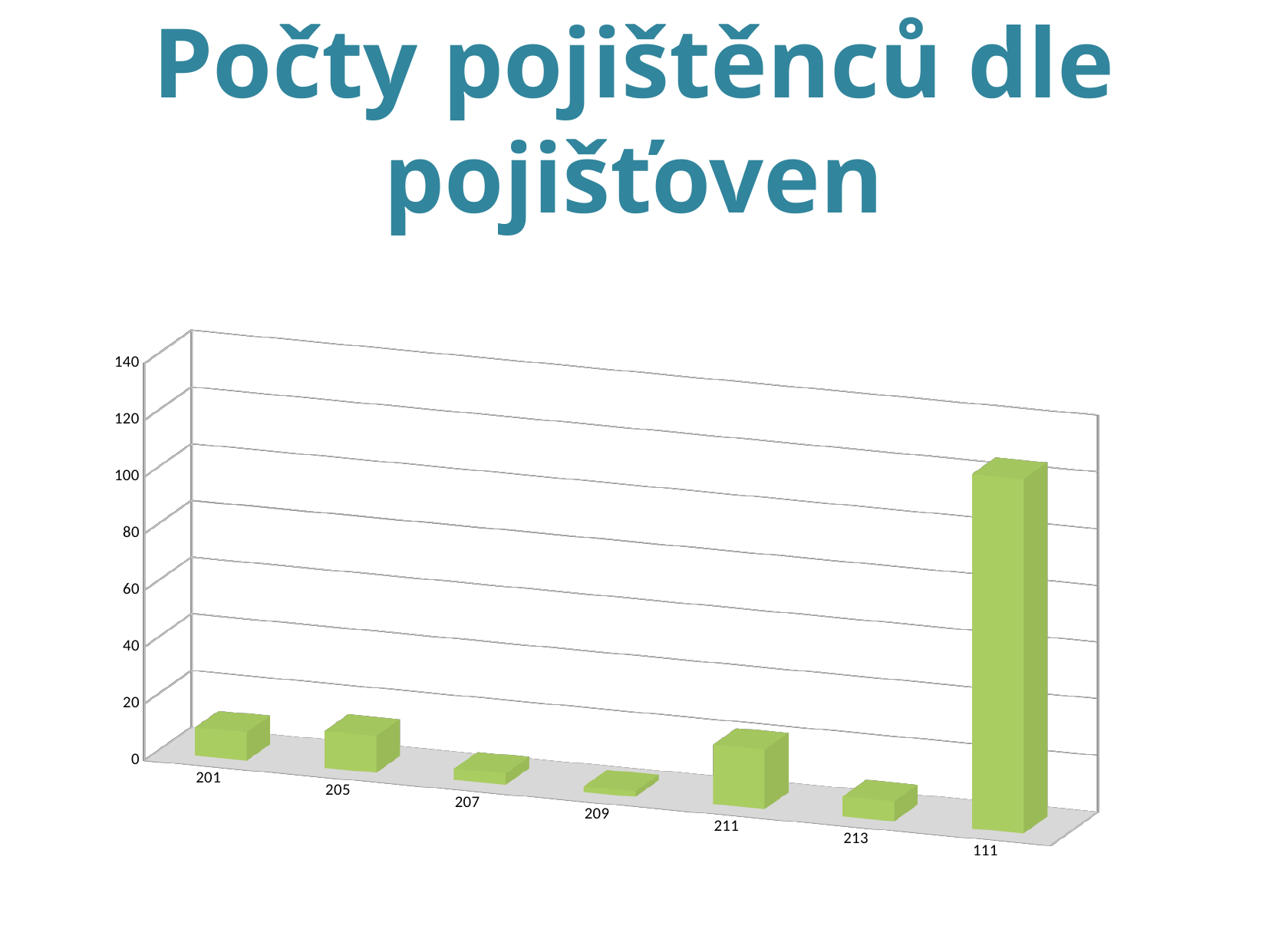
Which has the larger value, 111 or 201? 111 What colour are the bars in the chart? green What is the title of the slide? Počty pojištěnců dle pojišťoven Which category has the highest value in the chart? 111 What type of chart is shown on the slide? bar chart Is the value for 111 greater or less than 80? greater Which has the larger value, 211 or 209? 211 How many categories are shown on the x axis of the chart? 7 Is the value for 211 greater or less than 40? less Which category has the lowest value in the chart? 209 Is the value for 201 greater or less than 20? less